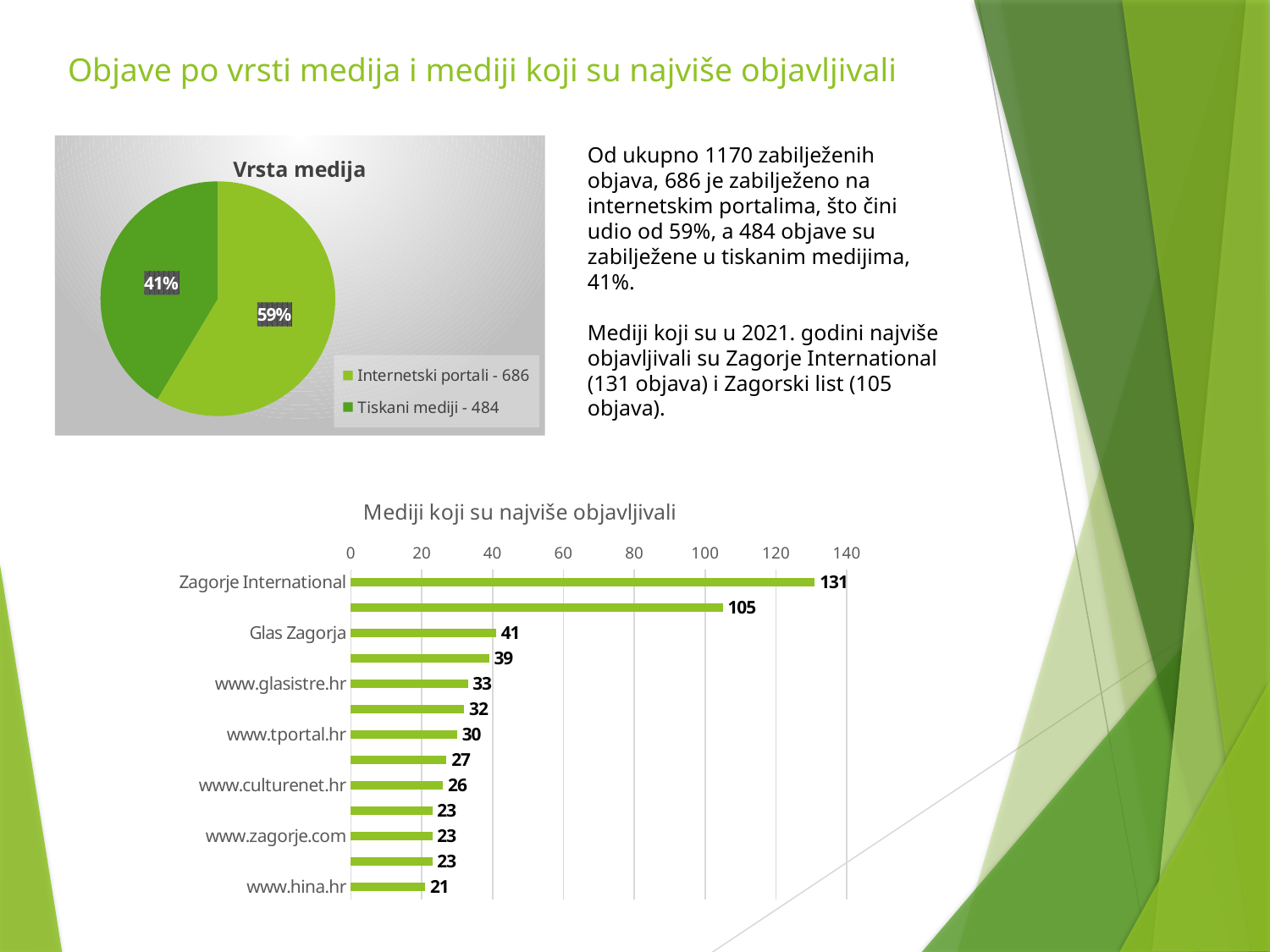
In the chart titled "Mediji koji su najviše objavljivali", which medium has the highest value? Zagorje International How many bars are plotted in the chart titled "Mediji koji su najviše objavljivali"? 13 In the chart titled "Mediji koji su najviše objavljivali", which medium has the lowest value? www.hina.hr In the chart titled "Mediji koji su najviše objavljivali", what is the value for www.hina.hr? 21 What kind of chart is the chart titled "Vrsta medija"? pie chart What kind of chart is the chart titled "Mediji koji su najviše objavljivali"? bar chart In the pie chart titled "Vrsta medija", what value does the legend give for Tiskani mediji? 484 In the pie chart titled "Vrsta medija", what share of the pie is Internetski portali? 59% In the chart titled "Mediji koji su najviše objavljivali", what is the value for Zagorje International? 131 In the chart titled "Mediji koji su najviše objavljivali", which has the larger value, www.glasistre.hr or www.tportal.hr? www.glasistre.hr How many entries does the legend of the chart titled "Vrsta medija" list? 2 In the chart titled "Mediji koji su najviše objavljivali", what is the difference between the values for Zagorje International and Glas Zagorja? 90